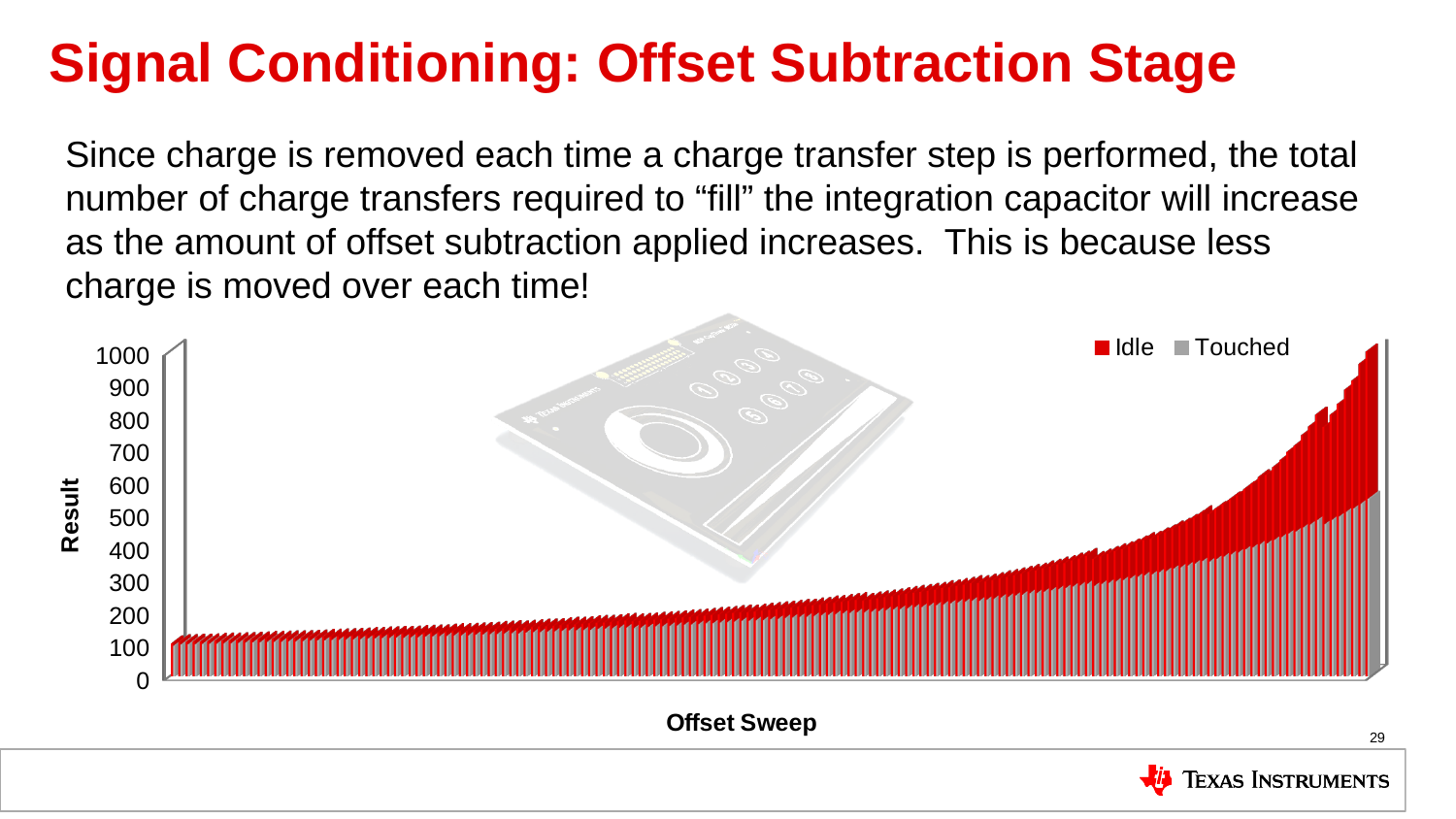
What kind of chart is shown on the slide? bar chart Which series, Idle or Touched, reaches higher values at the right end of the chart? Idle Are the bars at the far left of the chart greater or less than 200? less How many series does the chart's legend list? 2 Is the tallest Idle bar at the right end of the chart greater or less than 800? greater Do the bar values rise or fall from left to right along the Offset Sweep axis? rise What is the highest value shown on the chart's vertical axis? 1000 What are the two series named in the chart's legend? Idle and Touched What is the title of the chart's vertical axis? Result Is the tallest Touched bar at the right end of the chart greater or less than 400? greater